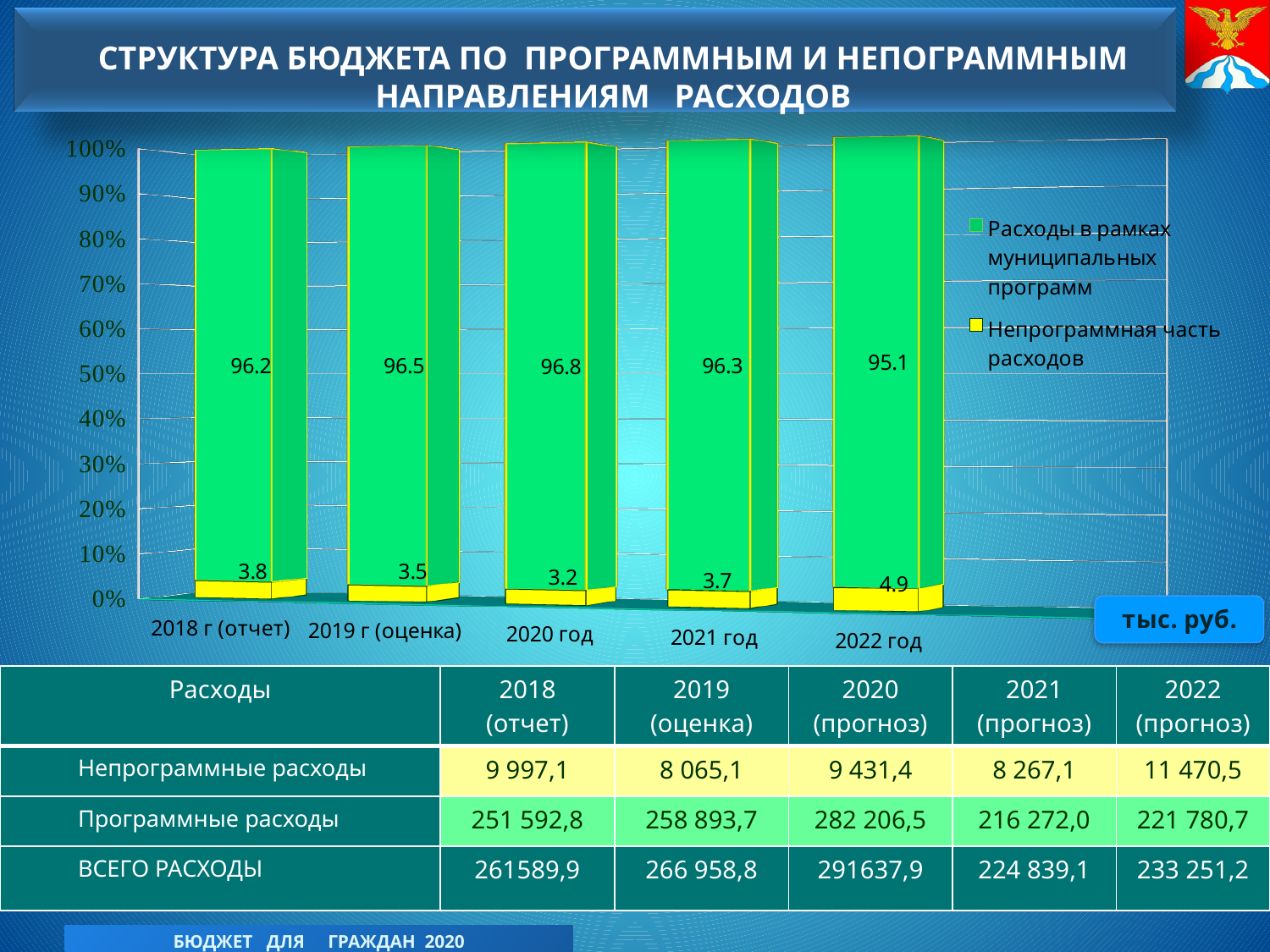
In which year is the value of 'Непрограммная часть расходов' the lowest? 2020 год What is the difference between the 'Непрограммная часть расходов' values for 2022 год and 2021 год? 1.2 What is the value of 'Расходы в рамках муниципальных программ' for 2020 год? 96.8 How many series does the chart legend list? 2 What is the value of 'Непрограммная часть расходов' for 2022 год? 4.9 Which is larger: the 'Расходы в рамках муниципальных программ' value for 2019 г (оценка) or for 2022 год? 2019 г (оценка) What is the total of the stacked bar for 2021 год? 100 In which year is the value of 'Расходы в рамках муниципальных программ' the highest? 2020 год How many categories (years) are plotted on the chart? 5 Which colour represents 'Непрограммная часть расходов' in the chart? Yellow What kind of chart is shown on the slide? Stacked bar chart What is the value of 'Непрограммная часть расходов' for 2018 г (отчет)? 3.8